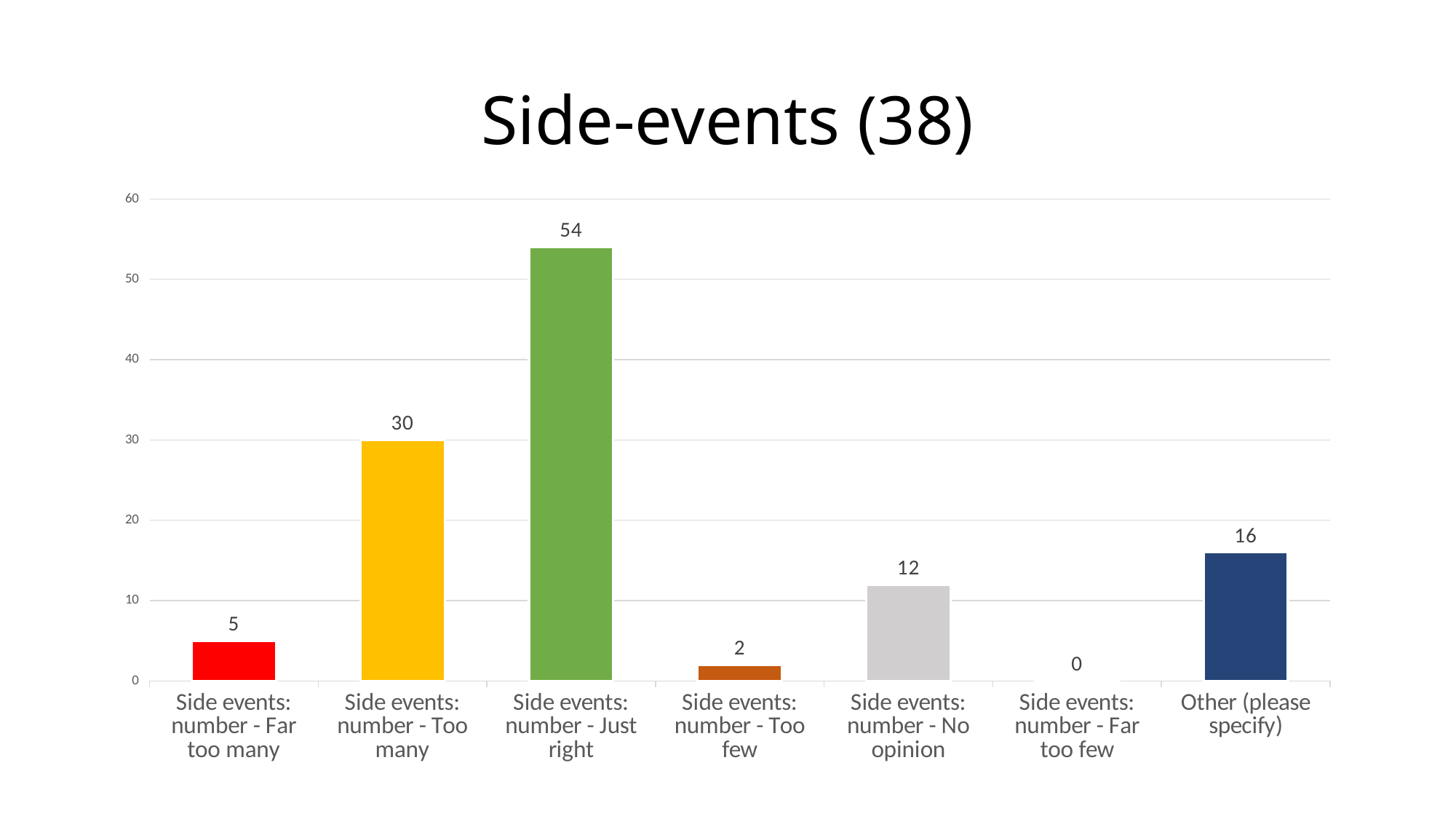
What is the value for "Other (please specify)"? 16 What is the title of the chart? Side-events (38) What is the value for "Side events: number - Far too few"? 0 Which is larger, the value for "Side events: number - No opinion" or the value for "Other (please specify)"? Other (please specify) What is the value for "Side events: number - Too many"? 30 Is the value for "Side events: number - Just right" greater or less than 50? greater What is the difference between the values for "Side events: number - Just right" and "Side events: number - Too many"? 24 What kind of chart is shown on the slide? bar chart How many categories are shown on the x axis? 7 Which category has the lowest value? Side events: number - Far too few What is the value for "Side events: number - Just right"? 54 Which category has the highest value? Side events: number - Just right